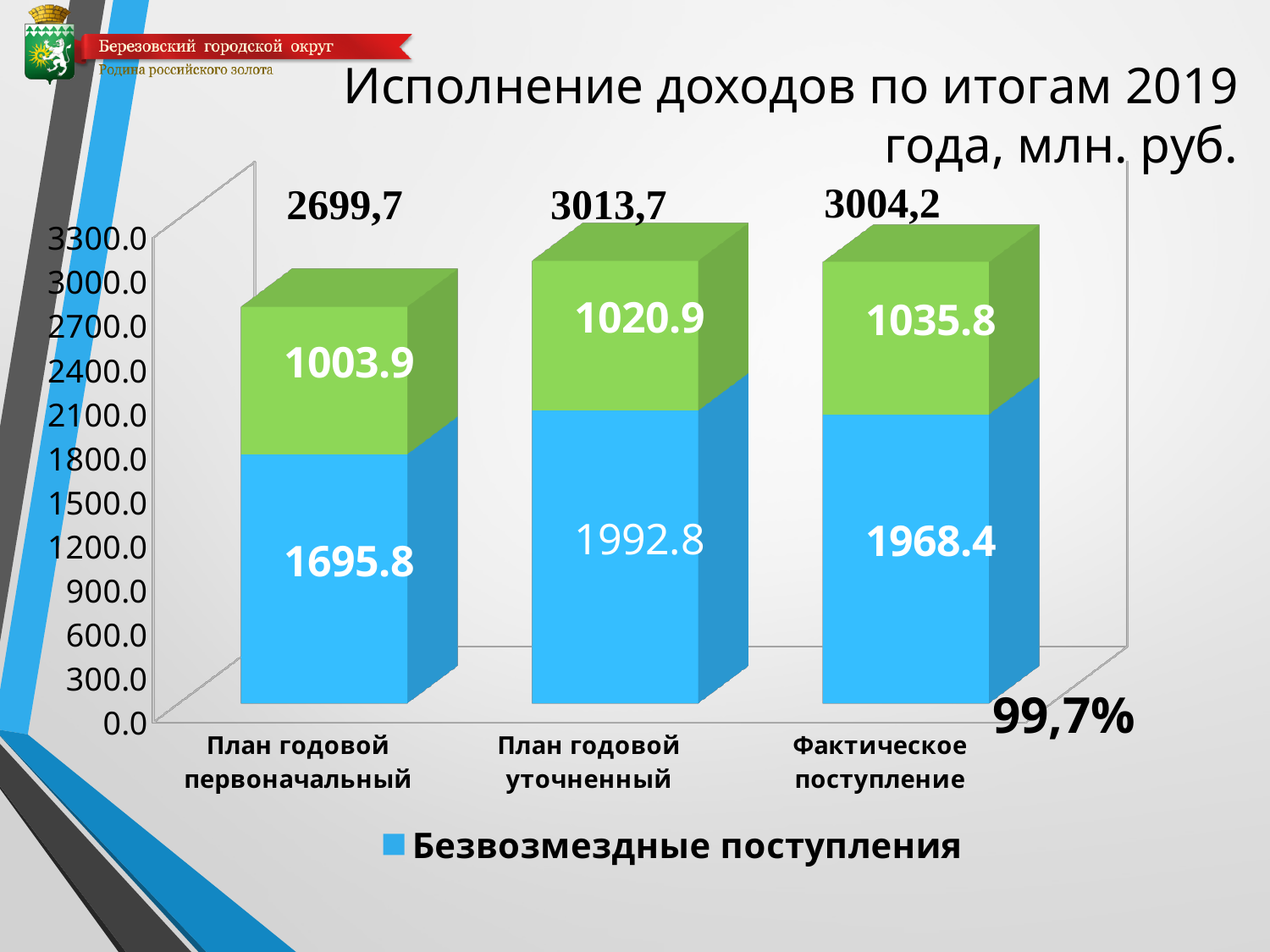
How many categories are shown on the x axis of the chart? 3 What percentage is printed at the bottom right of the chart? 99,7% What is the total shown above the bar for 'План годовой уточненный'? 3013,7 What is the value of the green segment for 'Фактическое поступление'? 1035.8 Which category has the highest total value? План годовой уточненный What is the value of the blue segment for 'План годовой первоначальный'? 1695.8 What is the difference between the green segment values of 'План годовой уточненный' and 'План годовой первоначальный'? 17.0 Which category has the lowest total value? План годовой первоначальный How many series does the chart legend list? 1 What is the value of the blue segment for 'План годовой уточненный'? 1992.8 What kind of chart is shown on the slide? stacked bar chart Which has the larger blue segment: 'План годовой уточненный' or 'Фактическое поступление'? План годовой уточненный